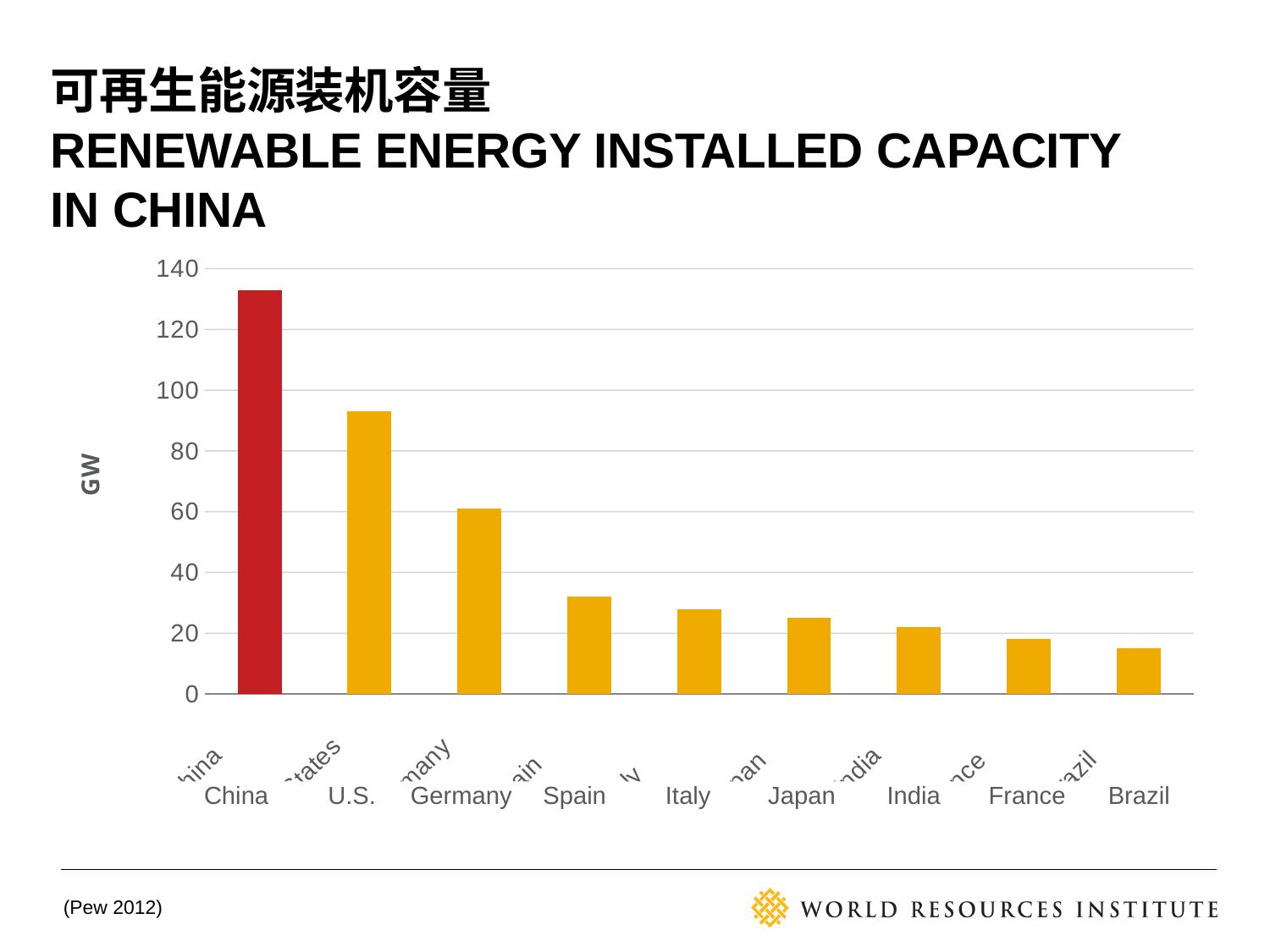
What kind of chart is shown on the slide? bar chart How many countries are shown on the chart? 9 Is the value for Germany greater or less than 80? less Is the value for Brazil greater or less than 20? less Which country has the highest renewable energy installed capacity? China Do the values rise or fall moving from left to right along the x axis? fall Which has a larger value, U.S. or Germany? U.S. Is the value for Spain greater or less than 40? less Which country has the lowest renewable energy installed capacity? Brazil What unit is shown on the y axis label? GW